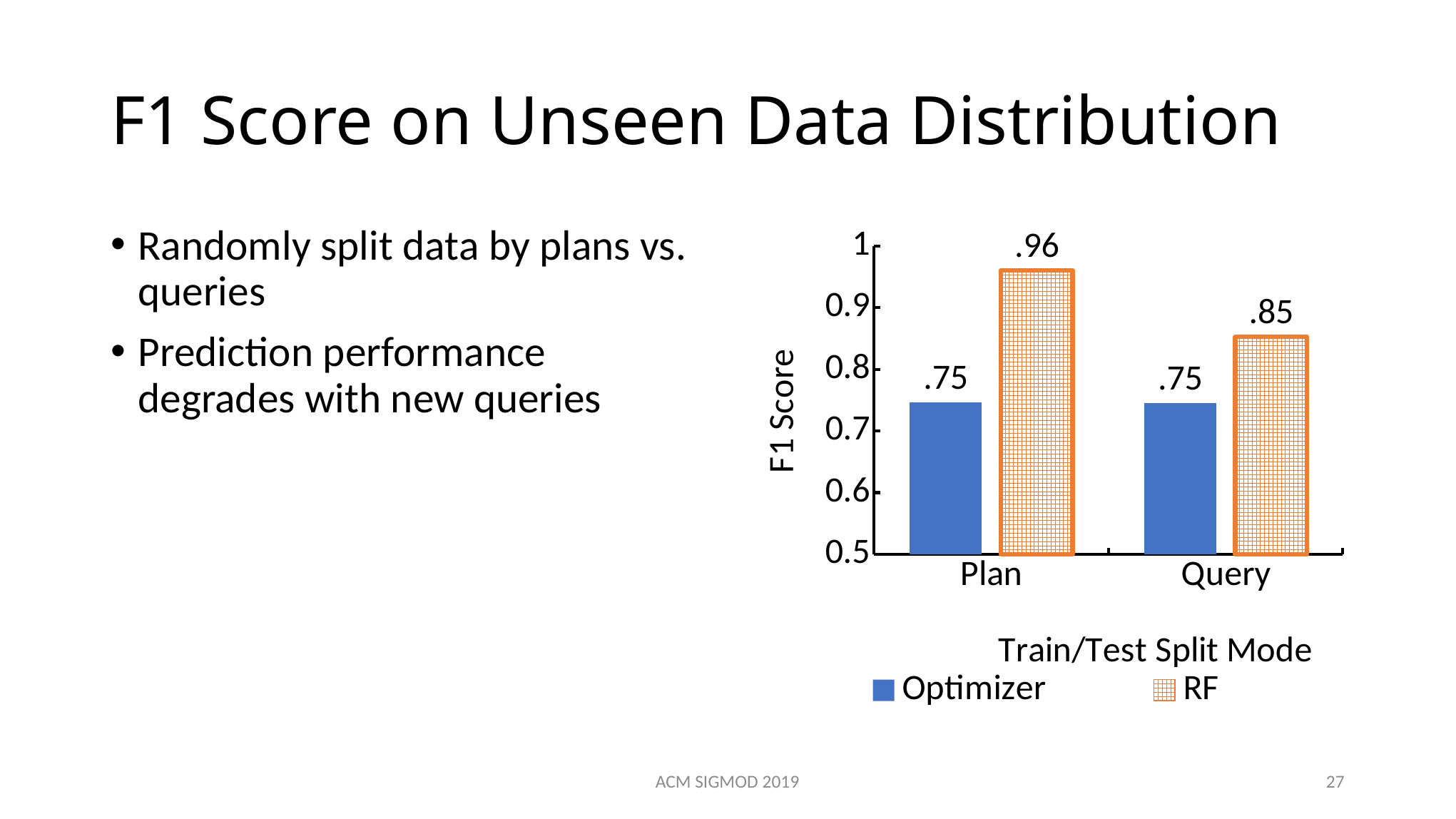
Which has a higher F1 Score in the Query split mode, Optimizer or RF? RF What kind of chart is shown on the slide? bar chart Which bar has the highest F1 Score on the chart? RF, Plan What is the F1 Score for RF in the Query split mode? .85 What is the difference between the RF F1 Score for Plan and for Query? .11 What is the label of the y axis? F1 Score How many series does the legend list? 2 Is the RF F1 Score for Query greater or less than 0.9? less How many train/test split modes are shown on the x axis? 2 What is the difference between the RF and Optimizer F1 Scores in the Plan split mode? .21 What is the F1 Score for Optimizer in the Query split mode? .75 What is the F1 Score for RF in the Plan split mode? .96